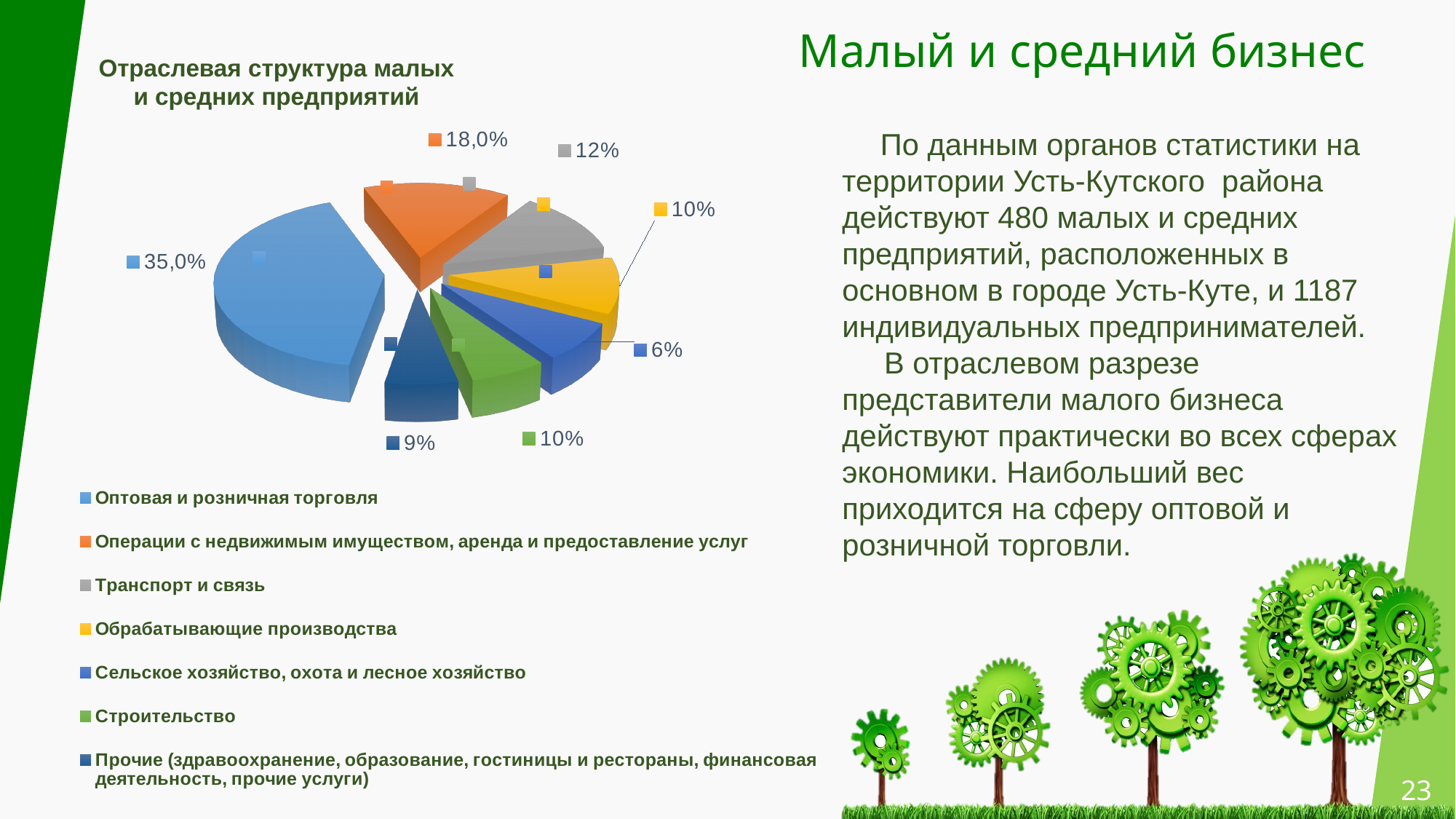
What share of the pie does "Сельское хозяйство, охота и лесное хозяйство" have? 6% What is the difference between the shares of "Оптовая и розничная торговля" and "Операции с недвижимым имуществом, аренда и предоставление услуг"? 17,0% What share of the pie does "Строительство" have? 10% What kind of chart is shown on the slide? Pie chart Which category has the smallest share of the pie? Сельское хозяйство, охота и лесное хозяйство Which has a larger share: "Транспорт и связь" or "Прочие (здравоохранение, образование, гостиницы и рестораны, финансовая деятельность, прочие услуги)"? Транспорт и связь Which category has the largest share of the pie? Оптовая и розничная торговля How many categories does the legend of the pie chart list? 7 What is the title of the chart? Отраслевая структура малых и средних предприятий What share of the pie does "Операции с недвижимым имуществом, аренда и предоставление услуг" have? 18,0% What share of the pie does "Оптовая и розничная торговля" have? 35,0% What share of the pie does "Транспорт и связь" have? 12%